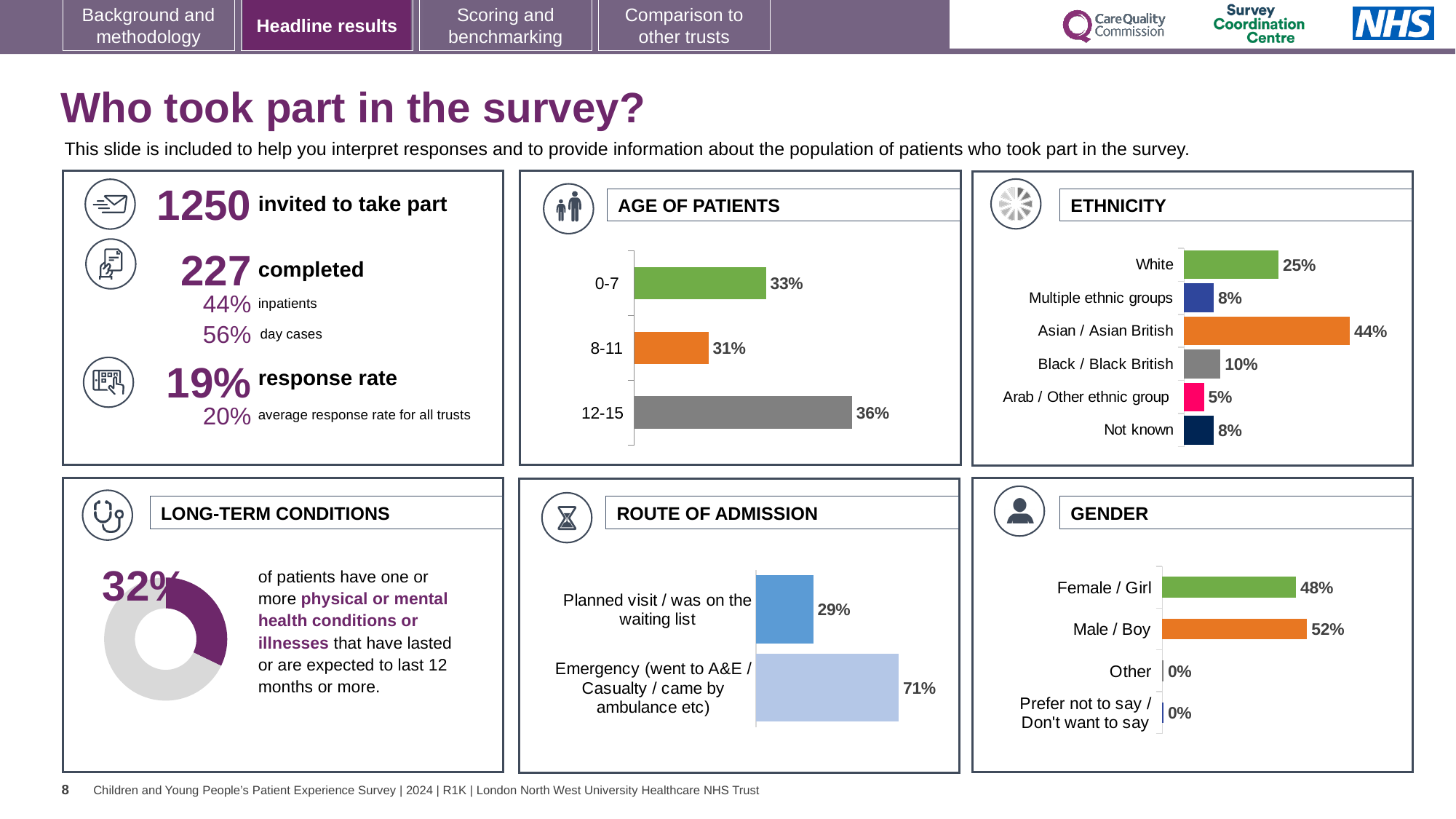
In the LONG-TERM CONDITIONS chart, what share of patients have one or more long-term conditions? 32% In the ROUTE OF ADMISSION chart, what percentage of patients came via Emergency (went to A&E / Casualty / came by ambulance etc)? 71% How many ethnic group categories are shown in the ETHNICITY chart? 6 In the GENDER chart, what is the value for Male / Boy? 52% In the ETHNICITY chart, what is the value for Asian / Asian British? 44% In the AGE OF PATIENTS chart, which age group has the lowest percentage? 8-11 In the ROUTE OF ADMISSION chart, which route has the larger value: Planned visit / was on the waiting list or Emergency? Emergency (went to A&E / Casualty / came by ambulance etc) In the ETHNICITY chart, what is the difference between the White and Black / Black British percentages? 15% In the GENDER chart, what is the difference between Male / Boy and Female / Girl? 4% In the AGE OF PATIENTS chart, what percentage of patients were aged 12-15? 36% What type of chart is used in the LONG-TERM CONDITIONS panel? Donut (pie) chart In the ETHNICITY chart, which ethnic group has the highest percentage? Asian / Asian British